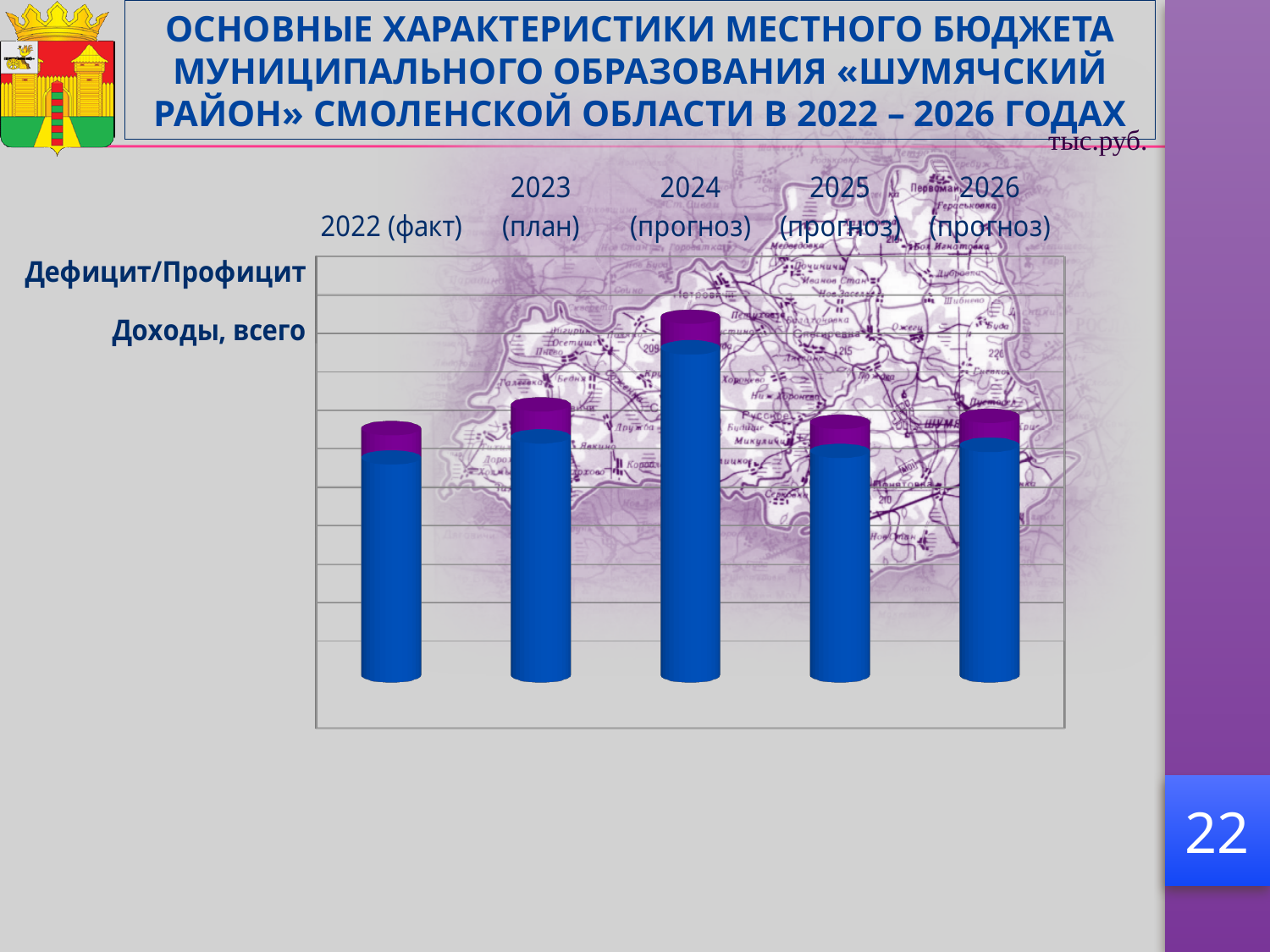
What unit of measurement is indicated for the chart values? тыс.руб. Which bar is taller: 2024 (прогноз) or 2022 (факт)? 2024 (прогноз) How many series are listed for the chart? 2 Does the bar height rise or fall from 2023 (план) to 2024 (прогноз)? rise Which year has the tallest bar in the chart? 2024 (прогноз) What kind of chart is shown on the slide? bar chart How many year categories are plotted along the x axis of the chart? 5 Which year category is labelled as 'факт' (actual) in the chart? 2022 Which bar is taller: 2023 (план) or 2025 (прогноз)? 2023 (план) Does the bar height rise or fall from 2024 (прогноз) to 2025 (прогноз)? fall What are the two series names listed to the left of the chart? Дефицит/Профицит; Доходы, всего